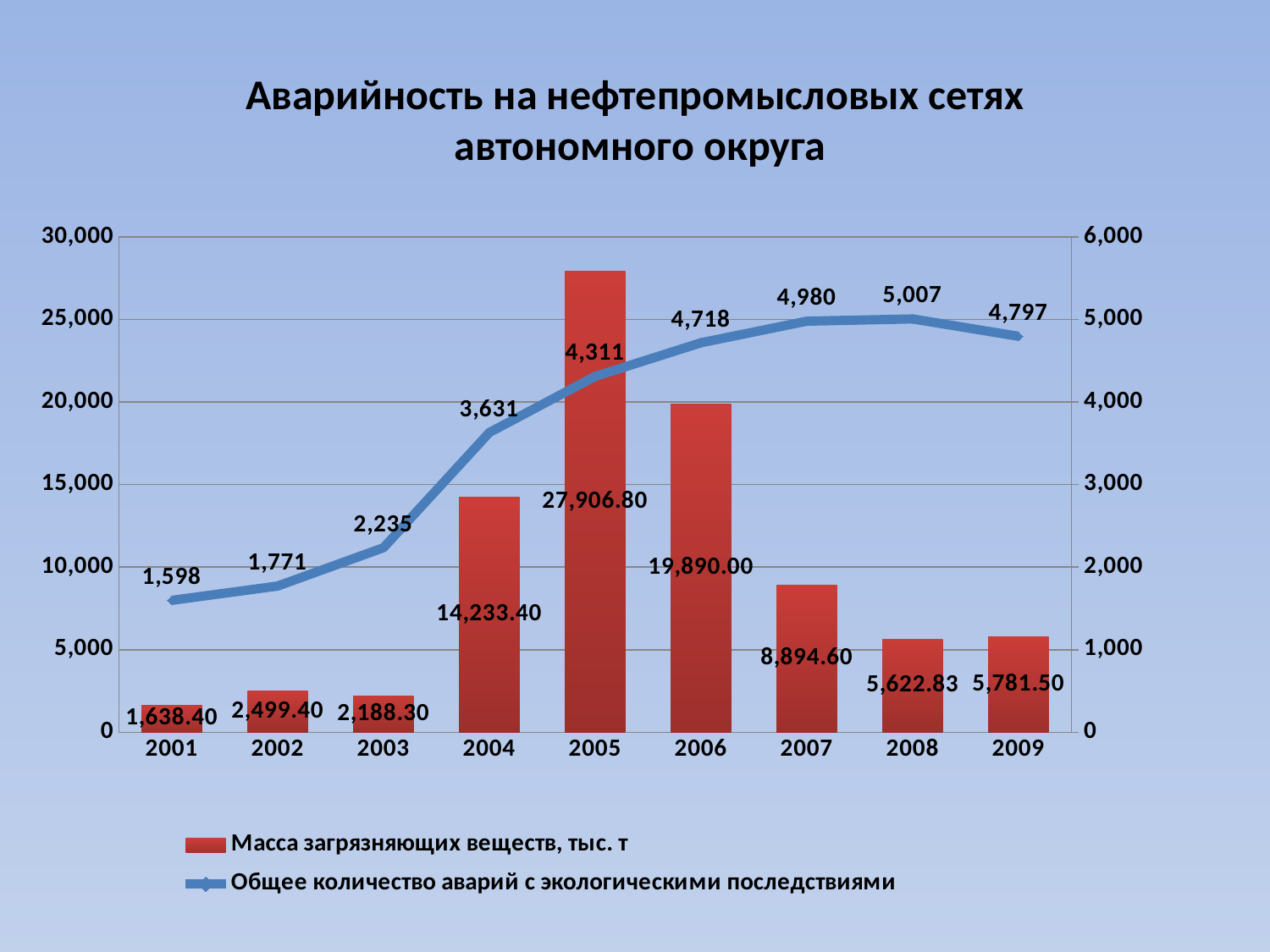
What is the value of "Масса загрязняющих веществ, тыс. т" for 2005? 27,906.80 How many series does the legend list? 2 What is the value of "Масса загрязняющих веществ, тыс. т" for 2008? 5,622.83 Which year has the larger value of "Масса загрязняющих веществ, тыс. т": 2004 or 2006? 2006 What colour are the bars for "Масса загрязняющих веществ, тыс. т"? Red In which year is "Общее количество аварий с экологическими последствиями" highest? 2008 How many years are shown on the x axis? 9 What kind of chart is shown on the slide? Combined bar and line chart What is the difference between the "Общее количество аварий с экологическими последствиями" values for 2009 and 2001? 3,199 Does "Общее количество аварий с экологическими последствиями" rise or fall from 2001 to 2008? Rise In which year is "Масса загрязняющих веществ, тыс. т" lowest? 2001 What is the value of "Общее количество аварий с экологическими последствиями" for 2003? 2,235